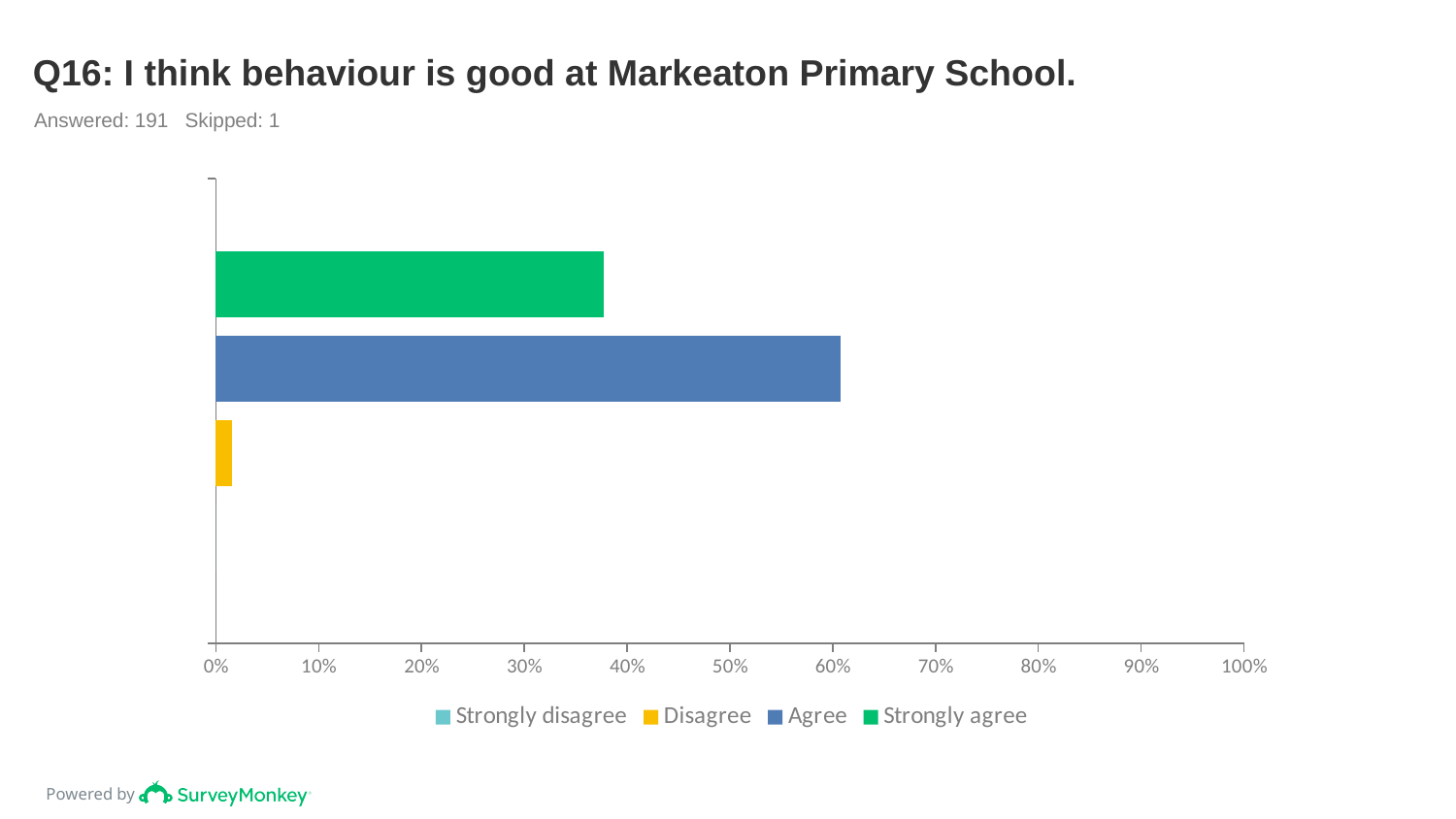
How many respondents answered this question according to the slide? 191 Which response has the highest value? Agree Which is larger, the value for Agree or the value for Strongly agree? Agree What kind of chart is shown on the slide? bar chart Which is larger, the value for Strongly agree or the value for Disagree? Strongly agree Is the value for Disagree greater or less than 10%? less What is the title of the chart? Q16: I think behaviour is good at Markeaton Primary School. How many series does the legend list? 4 Is the value for Agree greater or less than 50%? greater Is the value for Strongly agree greater or less than 30%? greater